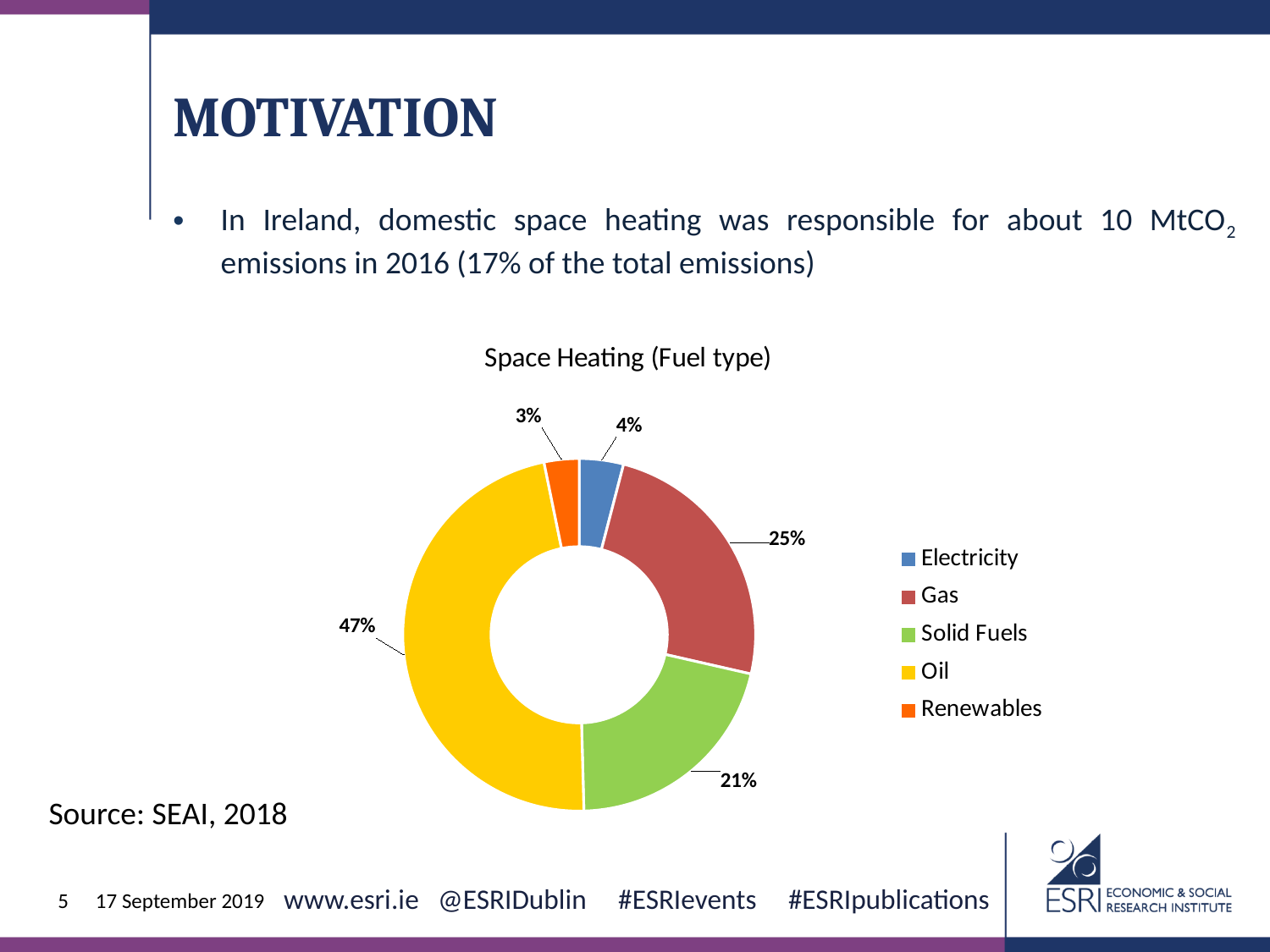
What share of space heating does Gas account for? 25% What is the title of the chart? Space Heating (Fuel type) What share of space heating does Solid Fuels account for? 21% What share of space heating does Oil account for? 47% What share of space heating does Electricity account for? 4% Which has a larger share of space heating, Gas or Solid Fuels? Gas Which fuel type has the smallest share of space heating? Renewables What kind of chart is shown on the slide? Pie chart (doughnut) How many fuel types are shown in the chart? 5 What share of space heating does Renewables account for? 3% Which fuel type has the largest share of space heating? Oil What is the difference in percentage points between the Oil share and the Gas share? 22